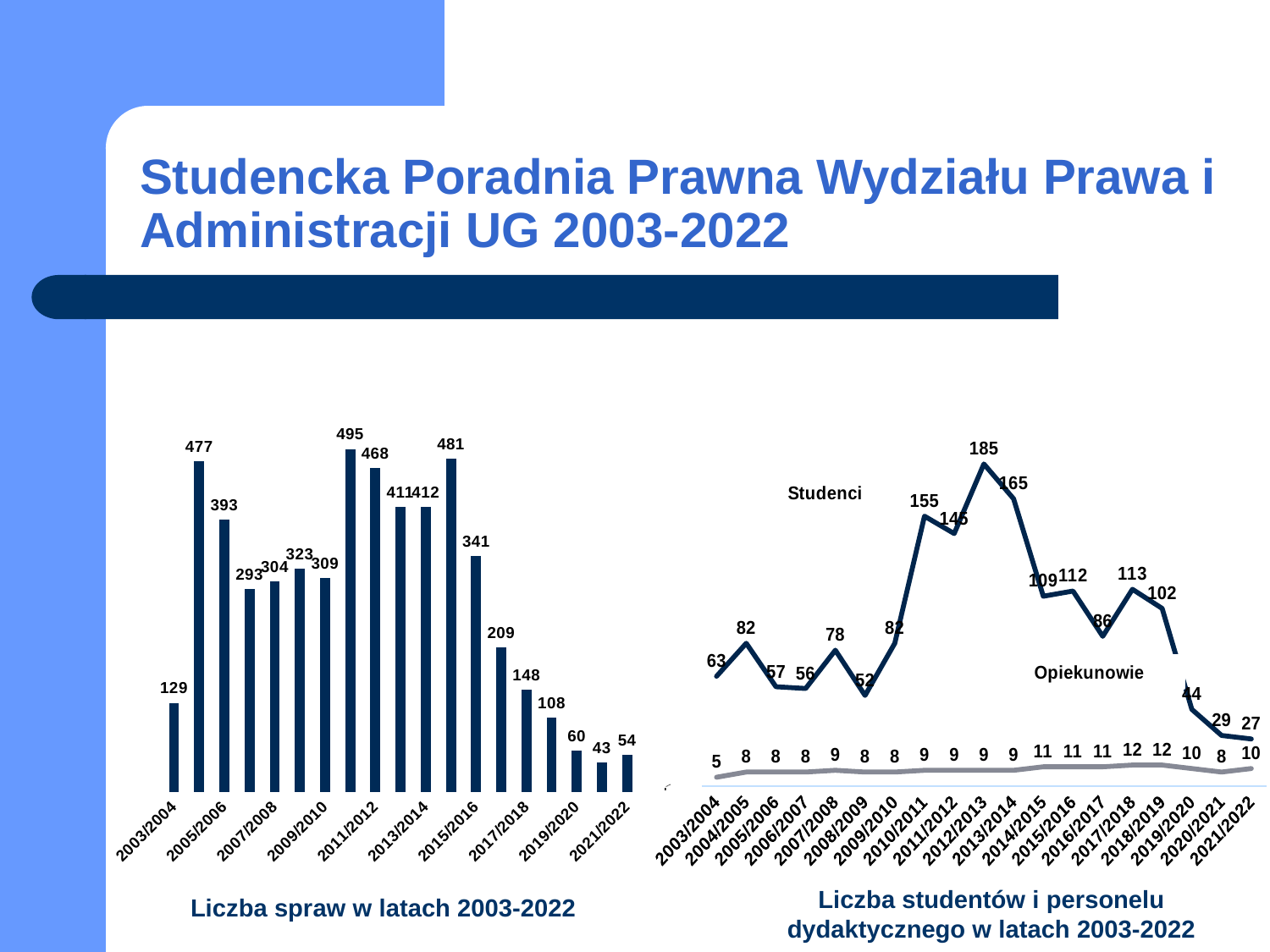
How many bars are in the left chart 'Liczba spraw w latach 2003-2022'? 19 In the left chart 'Liczba spraw w latach 2003-2022', what is the difference between the values for 2010/2011 and 2011/2012? 27 In the right chart 'Liczba studentów i personelu dydaktycznego w latach 2003-2022', which is larger for Studenci: 2010/2011 or 2013/2014? 2013/2014 In the left chart 'Liczba spraw w latach 2003-2022', what is the value for 2004/2005? 477 In the right chart 'Liczba studentów i personelu dydaktycznego w latach 2003-2022', what is the Studenci value for 2012/2013? 185 In the right chart 'Liczba studentów i personelu dydaktycznego w latach 2003-2022', what is the Opiekunowie value for 2003/2004? 5 In the left chart 'Liczba spraw w latach 2003-2022', which year has the lowest value? 2020/2021 In the left chart 'Liczba spraw w latach 2003-2022', which year has the highest value? 2010/2011 In the left chart 'Liczba spraw w latach 2003-2022', do the values rise or fall from 2014/2015 to 2020/2021? fall What kind of chart is the right chart, 'Liczba studentów i personelu dydaktycznego w latach 2003-2022'? line chart In the right chart 'Liczba studentów i personelu dydaktycznego w latach 2003-2022', what are the names of the two series shown? Studenci and Opiekunowie What kind of chart is the left chart, 'Liczba spraw w latach 2003-2022'? bar chart